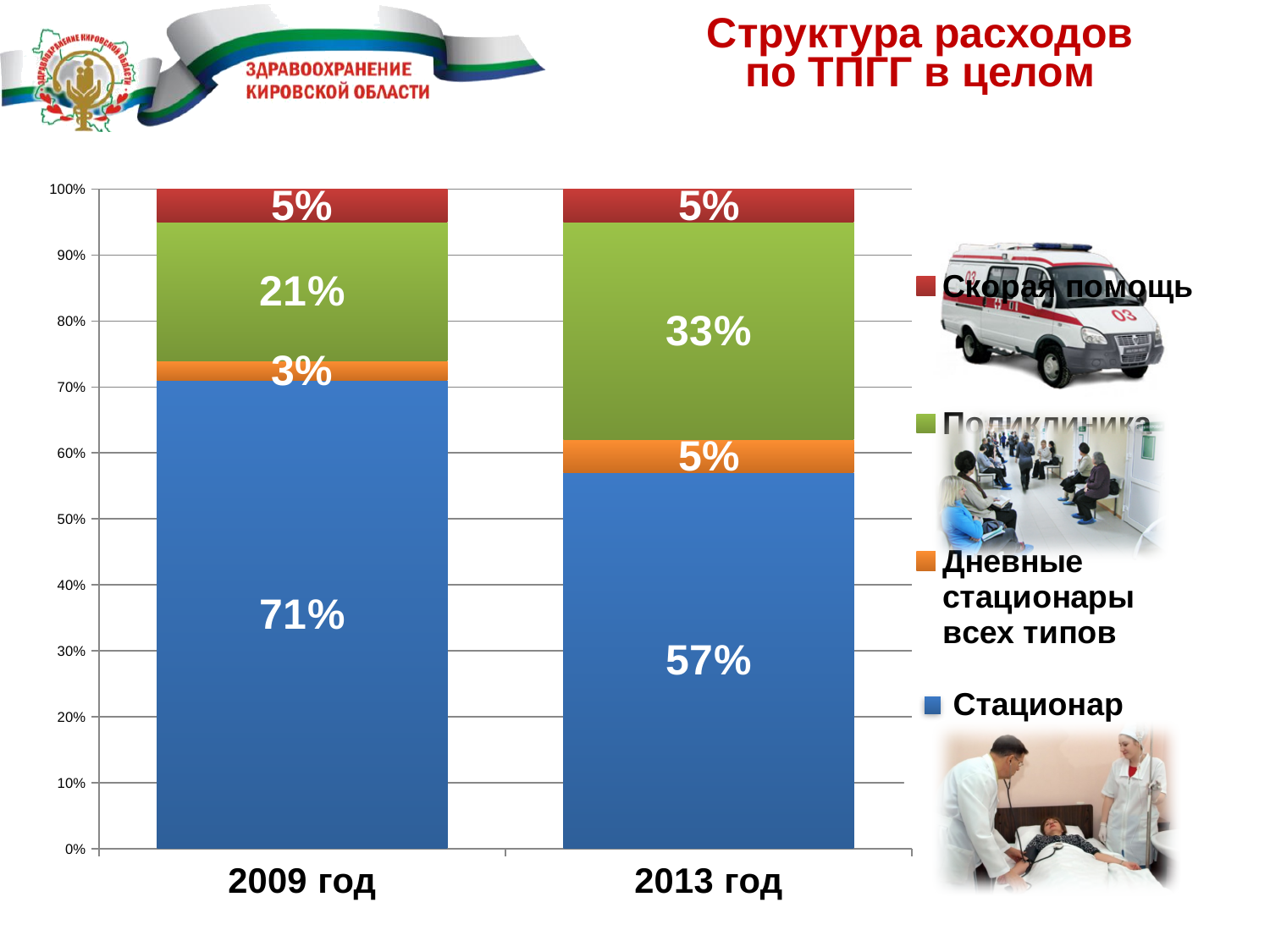
Does the Стационар share rise or fall from 2009 год to 2013 год? Fall Is the Стационар share larger in 2009 год or in 2013 год? 2009 год Which series has the smallest share in 2009 год? Дневные стационары всех типов Which series has the largest share in 2009 год? Стационар What share of expenses did Стационар account for in 2009 год? 71% What is the value for Поликлиника in 2013 год? 33% What kind of chart is shown on the slide? Stacked bar chart What is the value for Дневные стационары всех типов in 2009 год? 3% How many series does the legend list? 4 What is the value for Скорая помощь in 2013 год? 5% What share of expenses did Стационар account for in 2013 год? 57% By how many percentage points did the Поликлиника share change from 2009 год to 2013 год? 12 percentage points